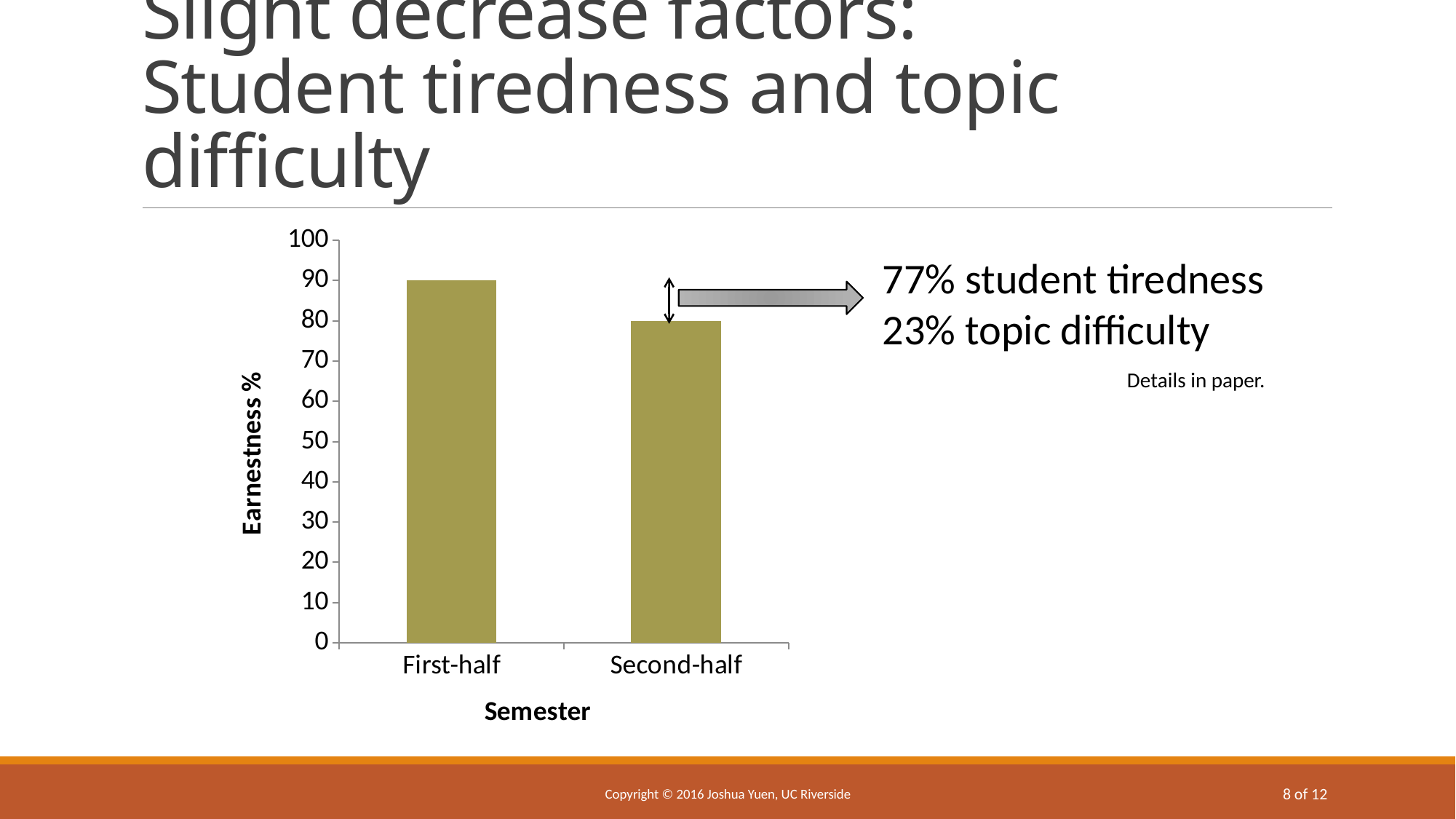
What is the label of the horizontal axis? Semester What is the Earnestness % value for First-half? 90 What is the Earnestness % value for Second-half? 80 What is the difference in Earnestness % between First-half and Second-half? 10 Which semester half has the highest Earnestness %? First-half Which is larger, the Earnestness % for First-half or for Second-half? First-half Do the values rise or fall from First-half to Second-half? fall How many bars does the chart show? 2 What is the label of the vertical axis? Earnestness % Is the value for Second-half greater or less than 70? greater Which semester half has the lowest Earnestness %? Second-half What kind of chart is shown on the slide? bar chart